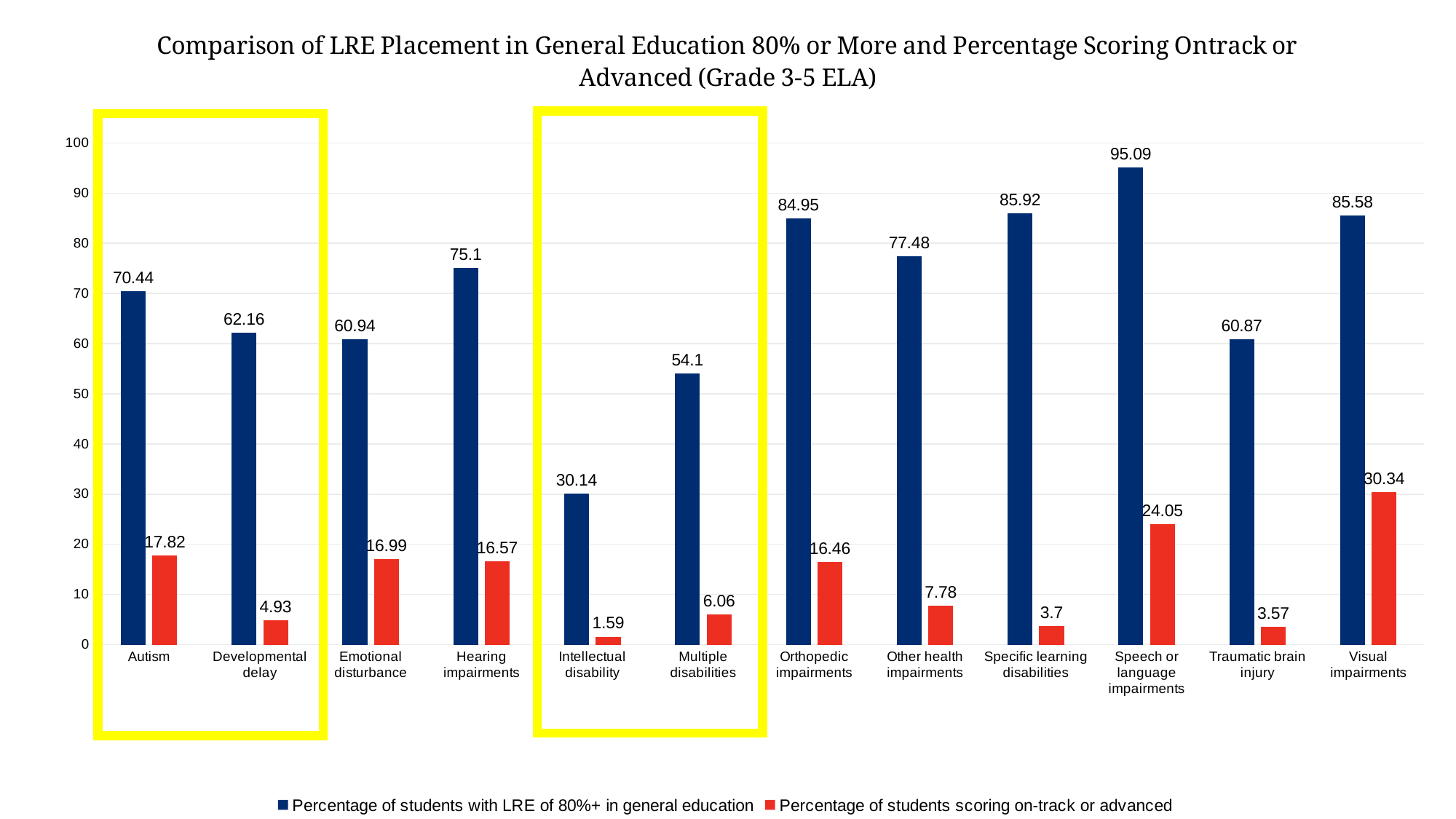
How many series does the legend list? 2 What is the percentage of students with LRE of 80%+ in general education for Autism? 70.44 What colour are the bars for the percentage of students scoring on-track or advanced? Red What is the difference between the percentage of students with LRE of 80%+ in general education and the percentage scoring on-track or advanced for Multiple disabilities? 48.04 What is the percentage of students scoring on-track or advanced for Intellectual disability? 1.59 Which category has the highest percentage of students with LRE of 80%+ in general education? Speech or language impairments Which has a higher percentage of students scoring on-track or advanced, Autism or Emotional disturbance? Autism What kind of chart is shown on the slide? Bar chart Is the percentage of students with LRE of 80%+ in general education for Intellectual disability greater or less than 40? less Which category has the lowest percentage of students scoring on-track or advanced? Intellectual disability How many disability categories are shown on the x axis? 12 What is the percentage of students scoring on-track or advanced for Visual impairments? 30.34